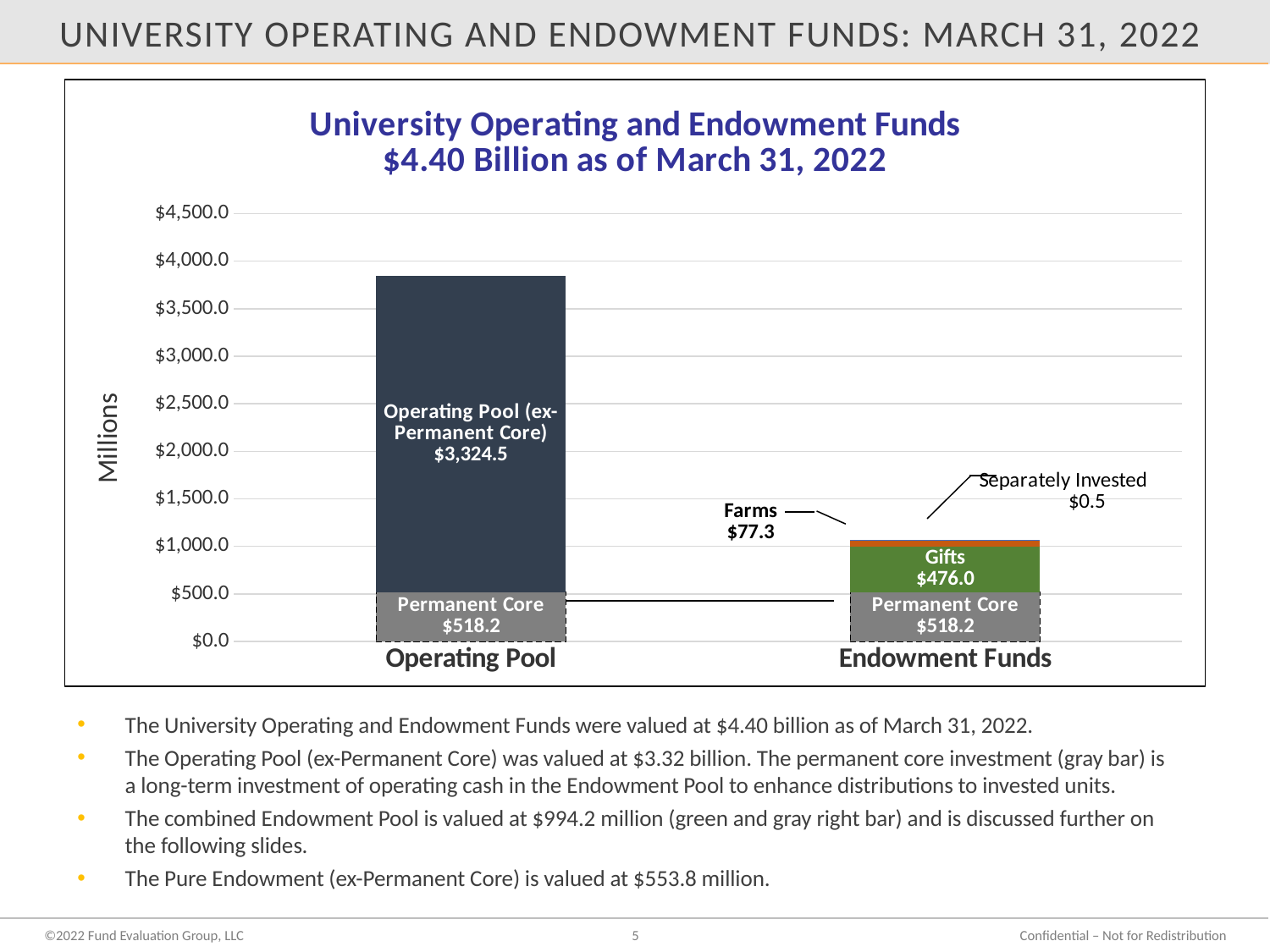
What is the total of the Endowment Funds stacked bar? $1,072.0 What is the value of the Operating Pool (ex-Permanent Core) segment in the Operating Pool bar? $3,324.5 How many categories are shown on the x axis? 2 What is the value of the Farms segment in the Endowment Funds bar? $77.3 What is the value of the Separately Invested segment in the Endowment Funds bar? $0.5 What is the value of the Permanent Core segment in the Endowment Funds bar? $518.2 What is the difference between the Operating Pool (ex-Permanent Core) segment and the Gifts segment? $2,848.5 What is the total of the Operating Pool stacked bar? $3,842.7 Is the total of the Endowment Funds bar greater or less than $1,500.0? less Which bar is taller, Operating Pool or Endowment Funds? Operating Pool What is the value of the Gifts segment in the Endowment Funds bar? $476.0 What kind of chart is shown on the slide? Stacked bar chart